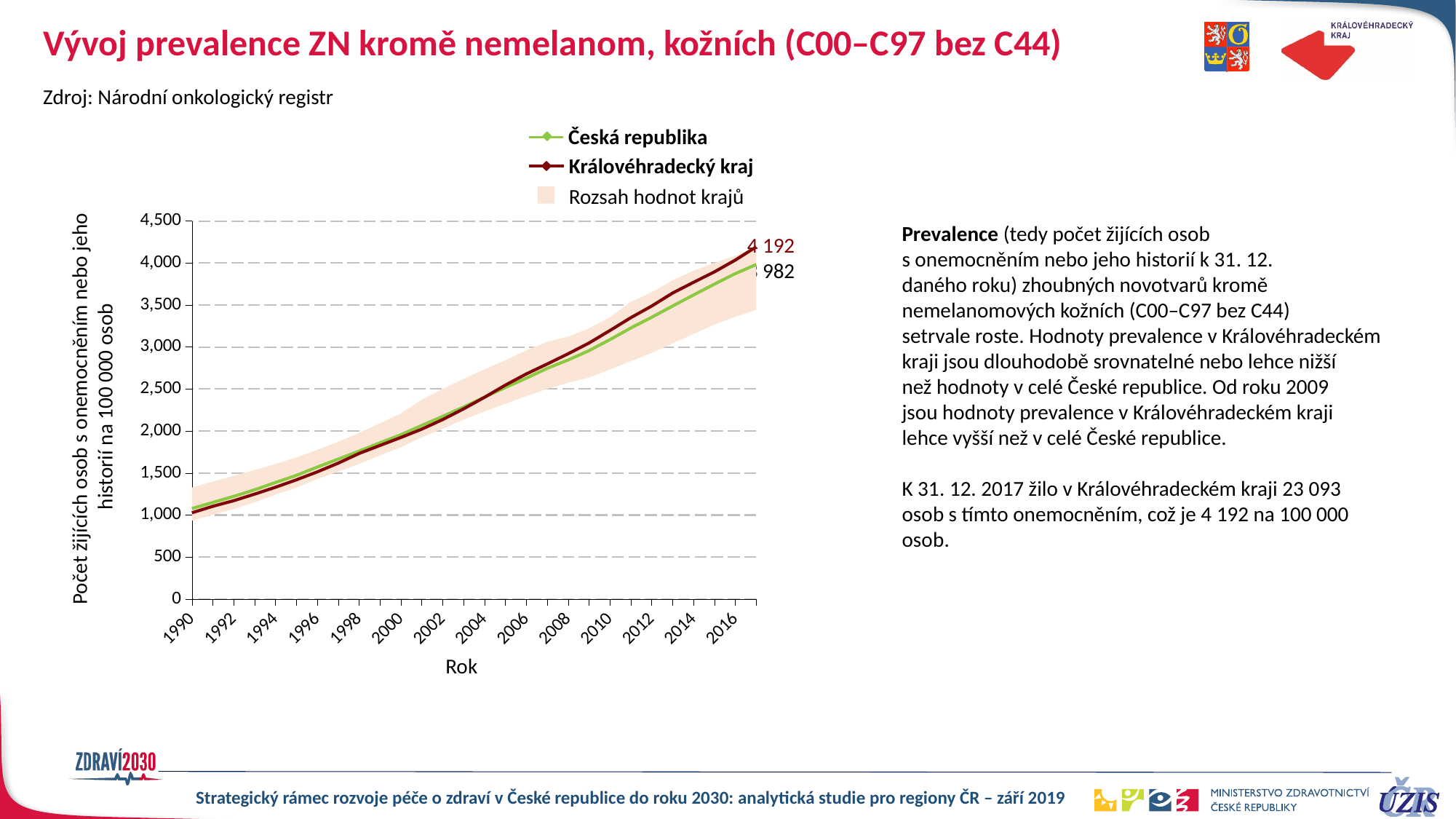
What is the difference between the final labelled values for Královéhradecký kraj (4 192) and Česká republika (3 982)? 210 What is the labelled value for Česká republika at the end of the series (2017)? 3 982 How many entries does the chart legend list? 3 Is the value for Česká republika in 2010 greater or less than 2,500? greater Do the prevalence values rise or fall over the years from 1990 to 2017? rise Is the value for Královéhradecký kraj in 1990 greater or less than 1,500? less What is the labelled value for Královéhradecký kraj at the end of the series (2017)? 4 192 What data source is cited for the chart? Národní onkologický registr What is the label of the x axis of the chart? Rok What kind of chart is shown on the slide? line chart Is the value for Královéhradecký kraj in 2000 greater or less than 2,500? less At the end of the series, which is higher: Královéhradecký kraj or Česká republika? Královéhradecký kraj